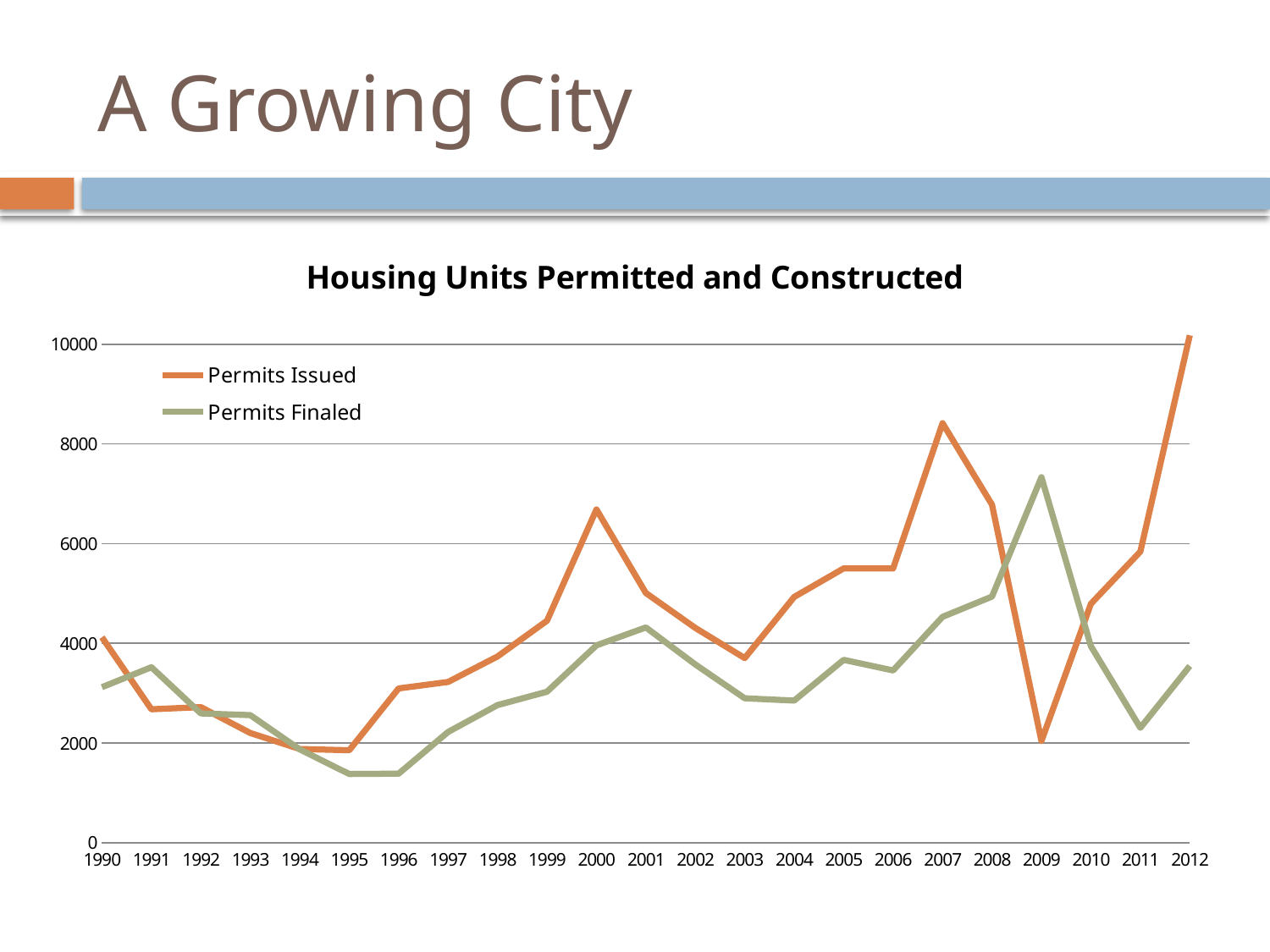
How many series does the legend list? 2 What kind of chart is shown on the slide? line chart In which year is the Permits Issued value highest? 2012 Is the Permits Finaled value for 1995 greater or less than 2000? less In which year is the Permits Finaled value highest? 2009 Is the Permits Finaled value for 2009 greater or less than 6000? greater Does the Permits Issued line rise or fall from 2009 to 2012? rise How many years are plotted along the x axis? 23 Is the Permits Issued value for 2000 greater or less than 6000? greater In 2009, which series has the larger value, Permits Issued or Permits Finaled? Permits Finaled What is the title of the chart? Housing Units Permitted and Constructed